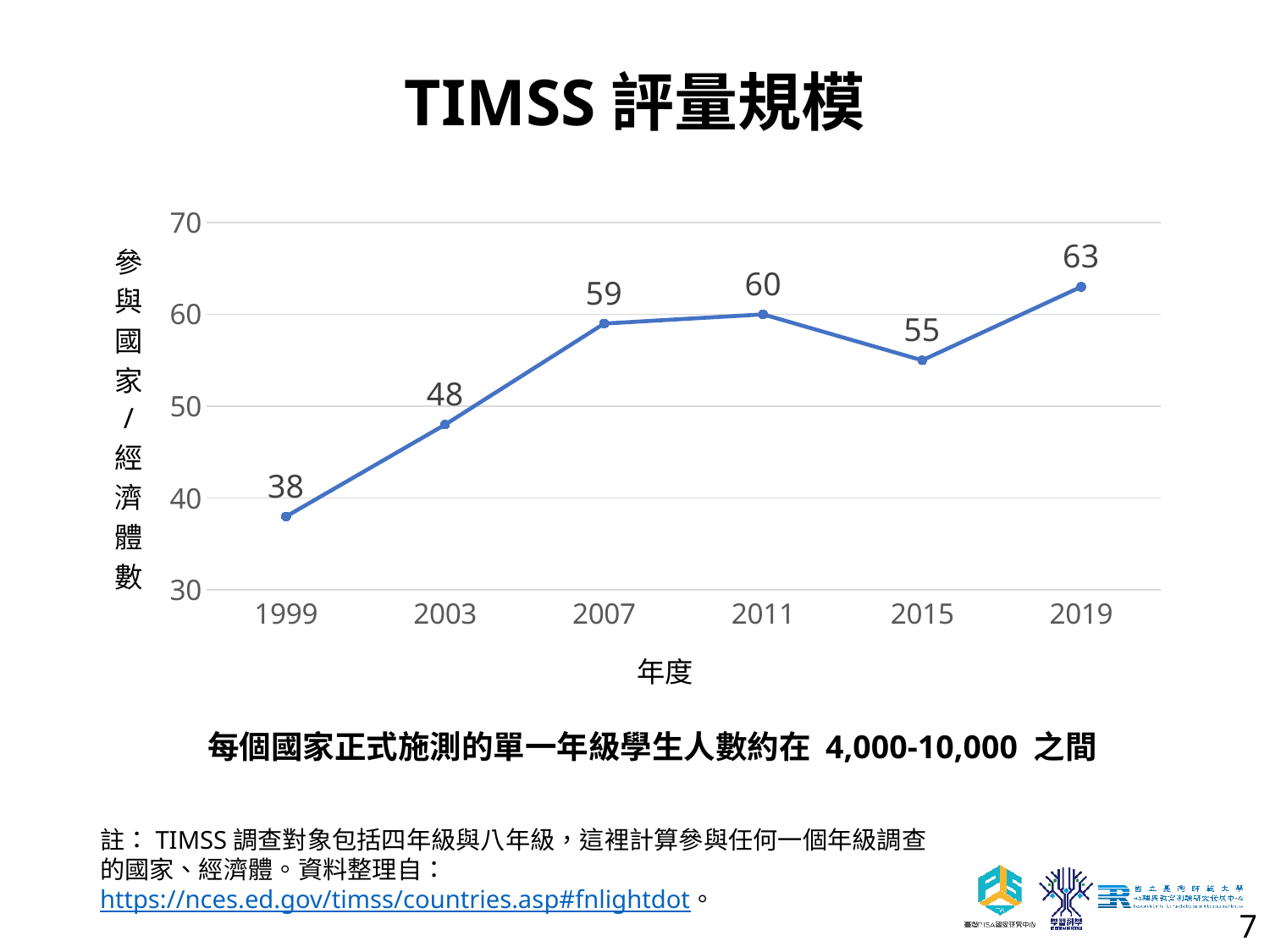
How many years are plotted on the x axis? 6 What is the number of participating countries/economies in 2015? 55 What is the difference between the values for 2019 and 1999? 25 Which year has a larger value, 2003 or 2015? 2015 Which year has the lowest number of participating countries/economies? 1999 What is the difference between the values for 2011 and 2015? 5 What kind of chart is shown on the slide? line chart What is the number of participating countries/economies in 1999? 38 Does the value rise or fall from 2011 to 2015? fall What is the number of participating countries/economies in 2007? 59 Which year has the highest number of participating countries/economies? 2019 Is the value for 2003 greater or less than 50? less